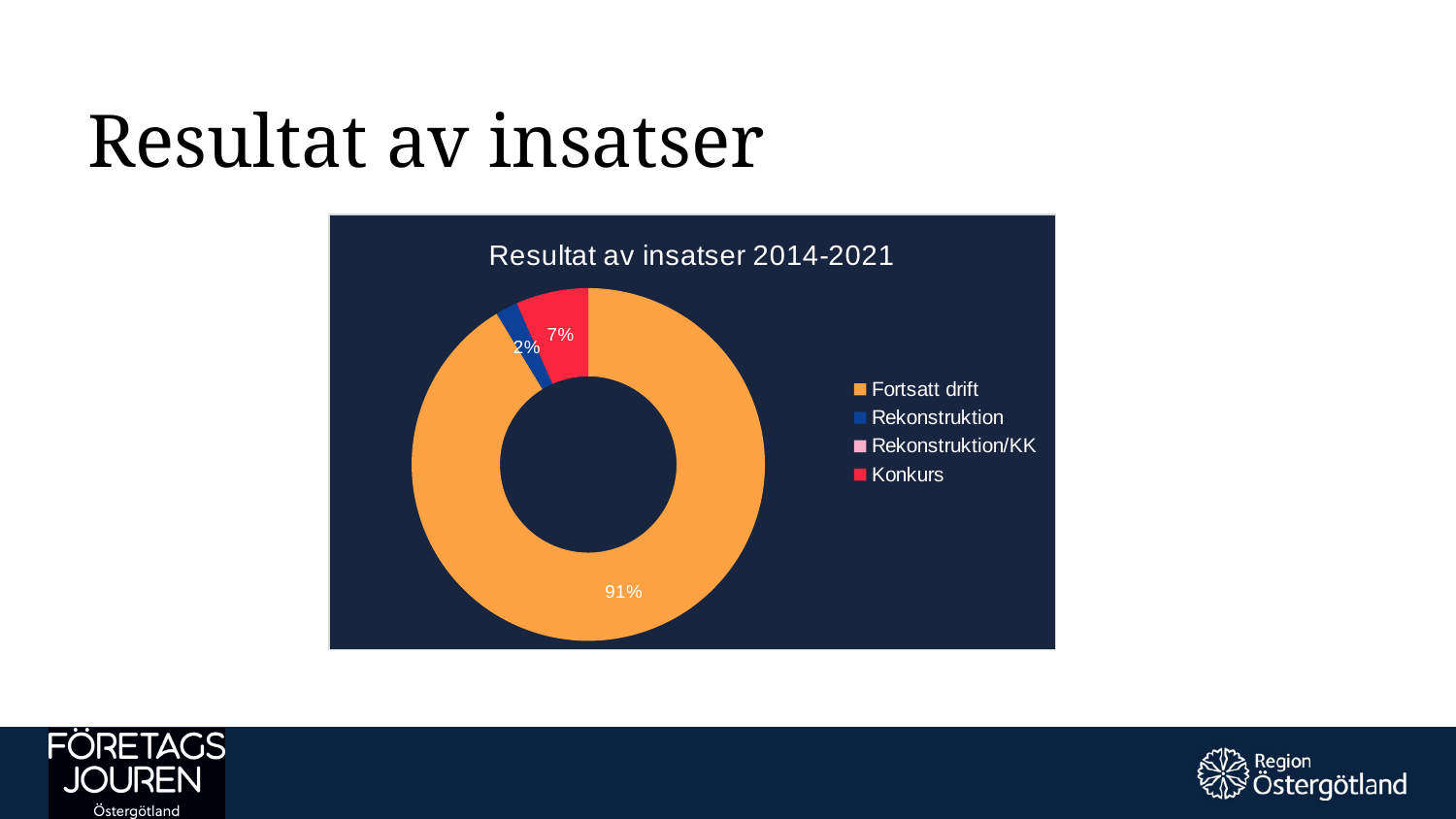
What kind of chart is shown on the slide? doughnut chart What is the difference in percentage points between Konkurs and Rekonstruktion? 5 percentage points Which category has the largest share of the doughnut? Fortsatt drift What colour represents Konkurs in the chart? red Is the share for Fortsatt drift greater or less than 50%? greater How many entries does the legend list? 4 What percentage is shown for Konkurs? 7% What is the difference in percentage points between Fortsatt drift and Konkurs? 84 percentage points What percentage is shown for Fortsatt drift? 91% Which is larger, the share for Konkurs or the share for Rekonstruktion? Konkurs What percentage is shown for Rekonstruktion? 2% What is the title of the chart? Resultat av insatser 2014-2021